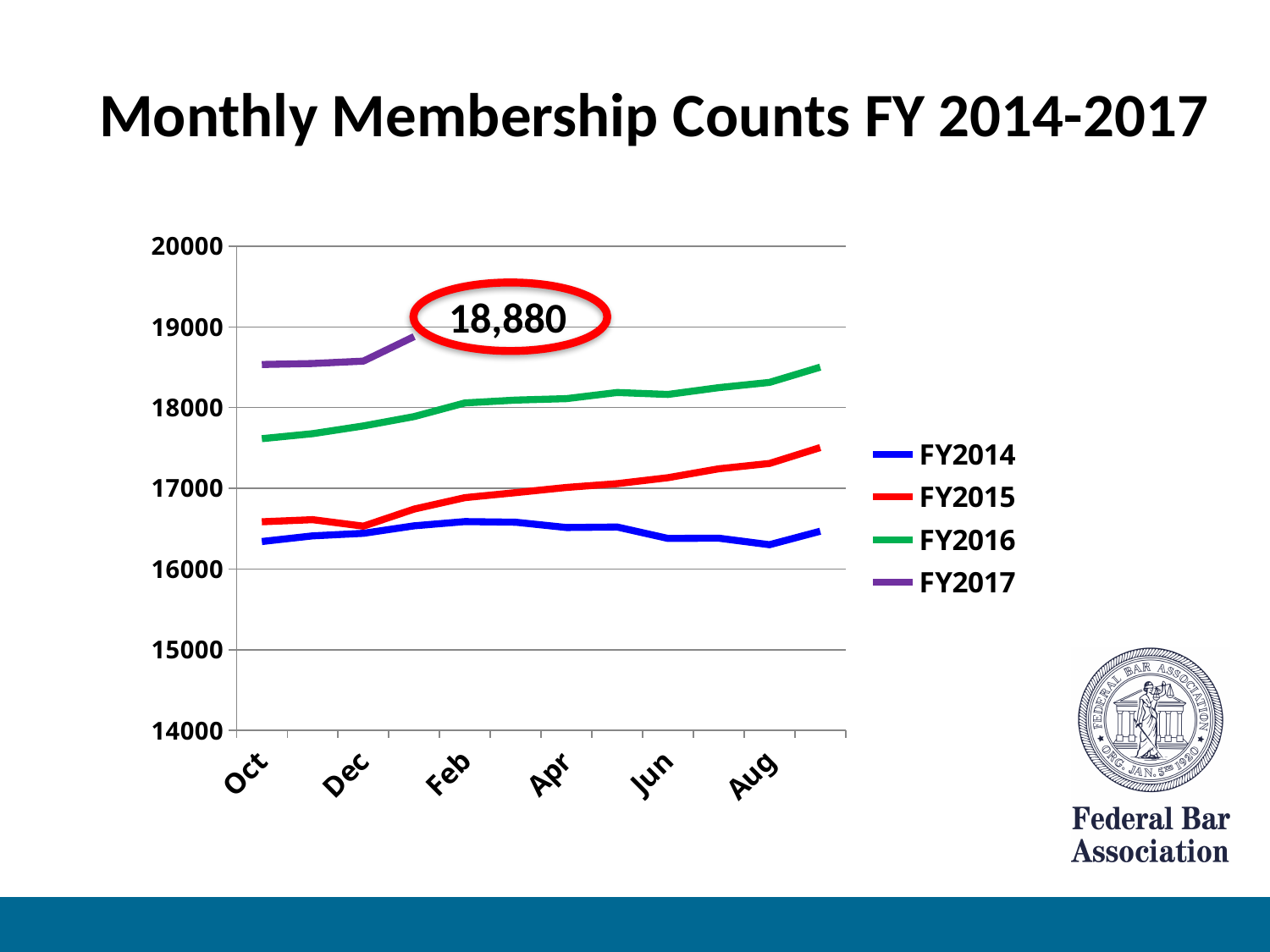
Does the FY2016 line rise or fall from Oct to the end of the year? rise How many month labels are shown on the x axis? 6 Is the FY2016 value for Oct greater or less than 17000? greater Which series has the highest membership counts on the chart? FY2017 What value is highlighted inside the red circle on the chart? 18,880 In Aug, which series is larger, FY2015 or FY2014? FY2015 Is the FY2014 value for Oct greater or less than 17000? less What kind of chart is shown on the slide? line chart Is the FY2017 value for Oct greater or less than 18000? greater How many series does the legend list? 4 Which series has the lowest membership counts on the chart? FY2014 What is the title of the chart? Monthly Membership Counts FY 2014-2017